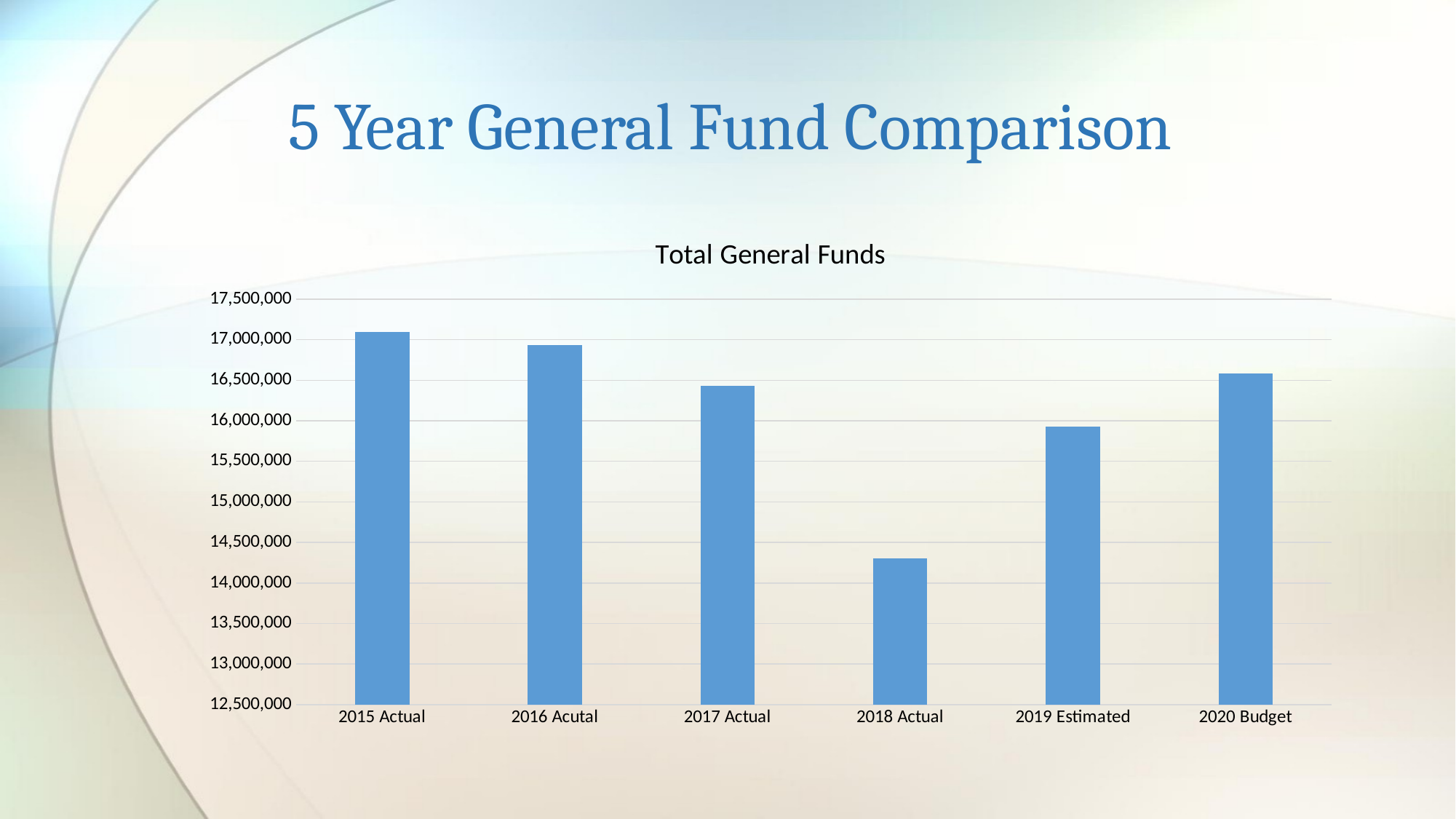
Is the value for 2020 Budget greater or less than 17,000,000? less What kind of chart is shown on the slide? Bar chart Which category has the lowest value? 2018 Actual Is the value for 2018 Actual greater or less than 15,000,000? less Is the value for 2019 Estimated greater or less than 15,500,000? greater Do the values rise or fall from 2015 Actual to 2018 Actual? fall Which is larger, the value for 2020 Budget or the value for 2019 Estimated? 2020 Budget Which category has the highest value? 2015 Actual How many categories are plotted on the x axis? 6 What is the title of the chart? Total General Funds